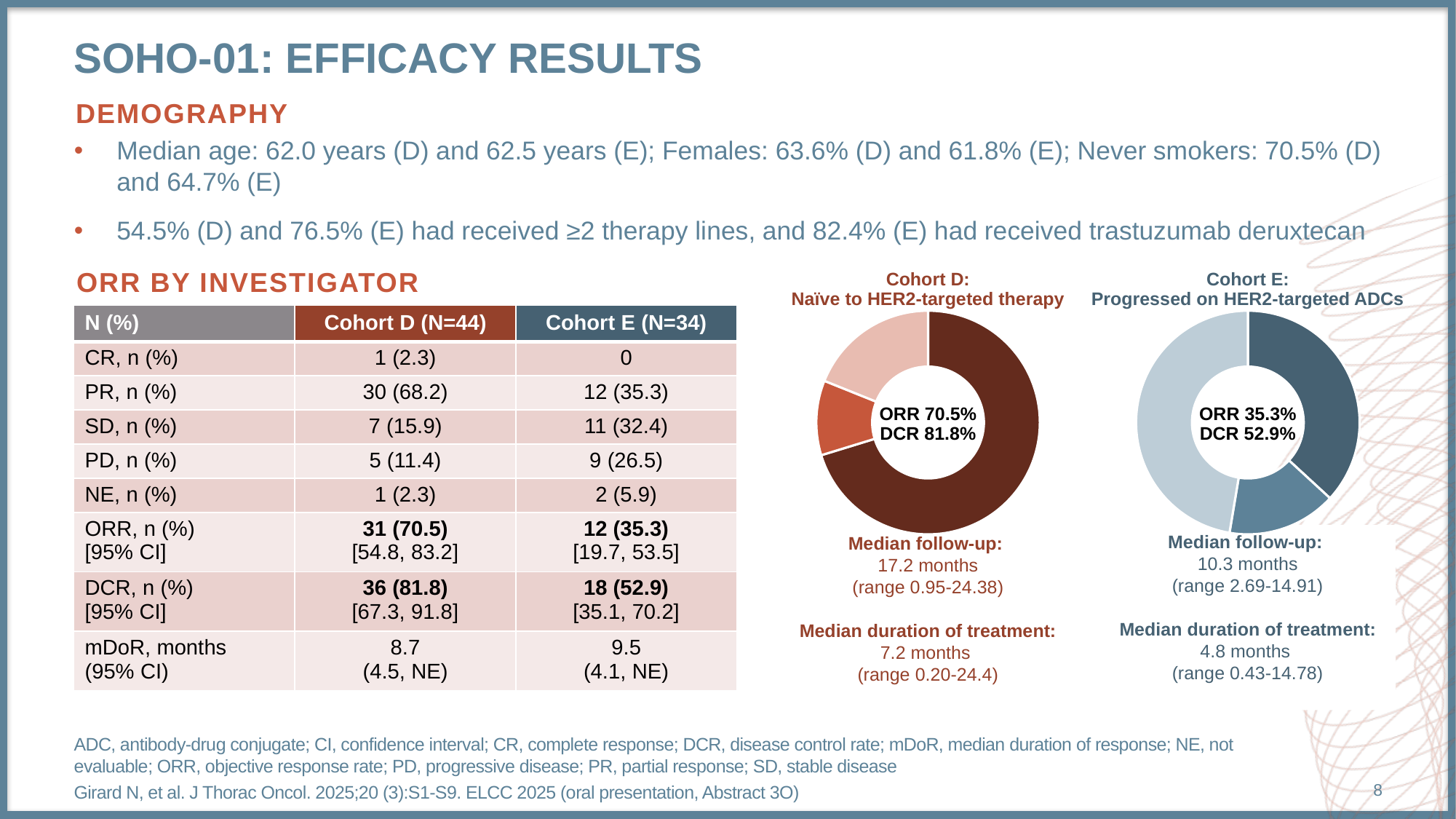
What kind of chart is used for Cohort D and Cohort E on the slide? Donut (pie) chart What median follow-up is reported below the Cohort D chart? 17.2 months (range 0.95-24.38) How many slices does the Cohort E donut chart have? 3 In the Cohort D chart, what ORR is shown in the centre? ORR 70.5% Which chart shows the higher ORR, Cohort D or Cohort E? Cohort D How many slices does the Cohort D donut chart have? 3 In the Cohort E chart, what DCR is shown in the centre? DCR 52.9% What is the full title of the Cohort E chart? Cohort E: Progressed on HER2-targeted ADCs What is the difference in ORR between the Cohort D chart and the Cohort E chart? 35.2 percentage points In the Cohort D chart, what DCR is shown in the centre? DCR 81.8% What is the difference in DCR between the Cohort D chart and the Cohort E chart? 28.9 percentage points In the Cohort E chart, what ORR is shown in the centre? ORR 35.3%